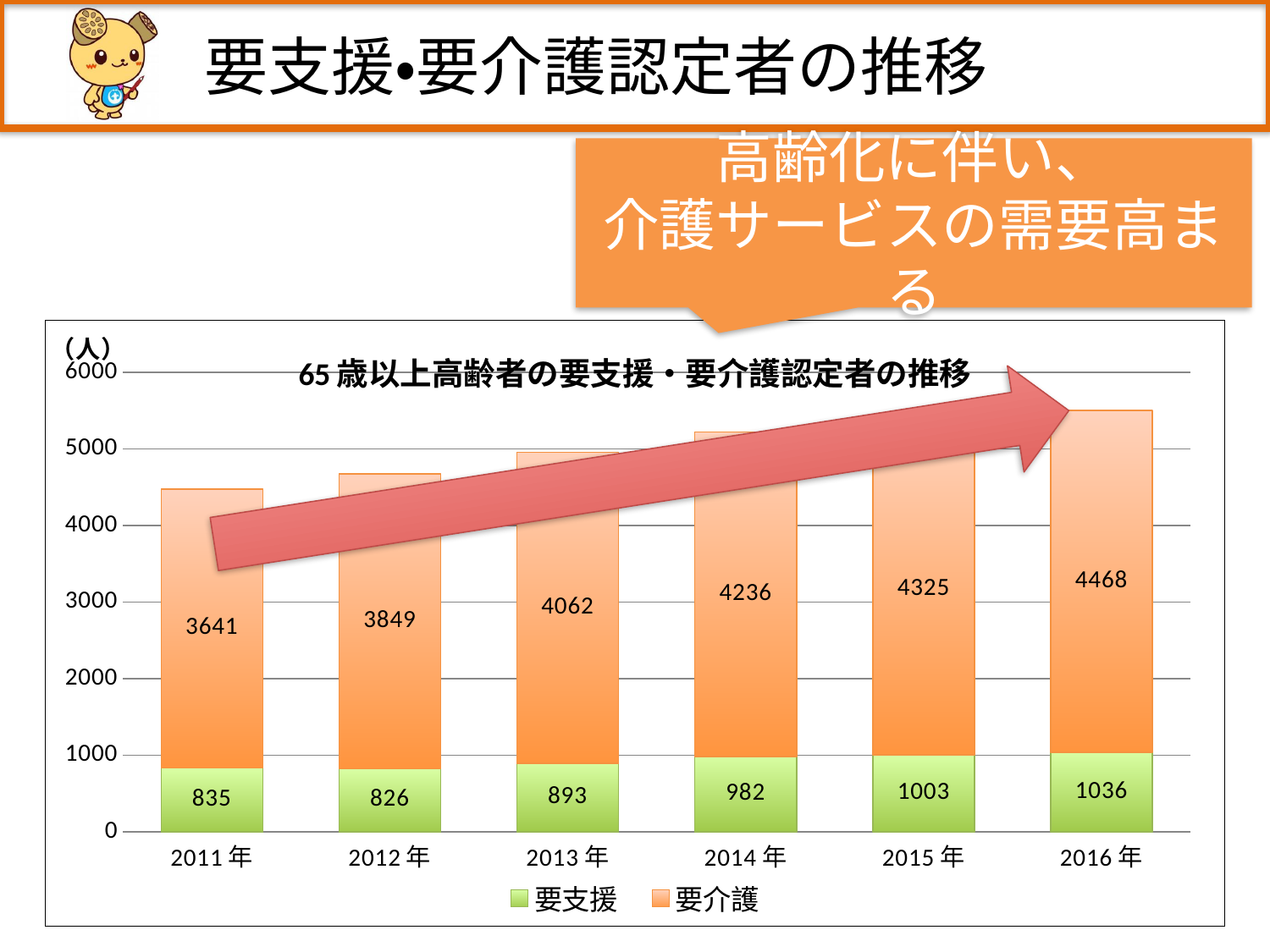
Does the 要介護 value rise or fall from 2011年 to 2016年? Rise Which year has the highest 要介護 value? 2016年 What is the difference between the 要介護 values for 2016年 and 2011年? 827 What is the title of the chart? 65歳以上高齢者の要支援・要介護認定者の推移 How many series does the legend list? 2 What is the value of 要支援 for 2012年? 826 What type of chart is shown on the slide? Stacked bar chart What is the value of 要介護 for 2014年? 4236 How many years are shown on the x axis? 6 Which year has the lowest 要支援 value? 2012年 What is the total of the stacked bar for 2015年? 5328 Which is larger, the 要支援 value for 2013年 or for 2014年? 2014年